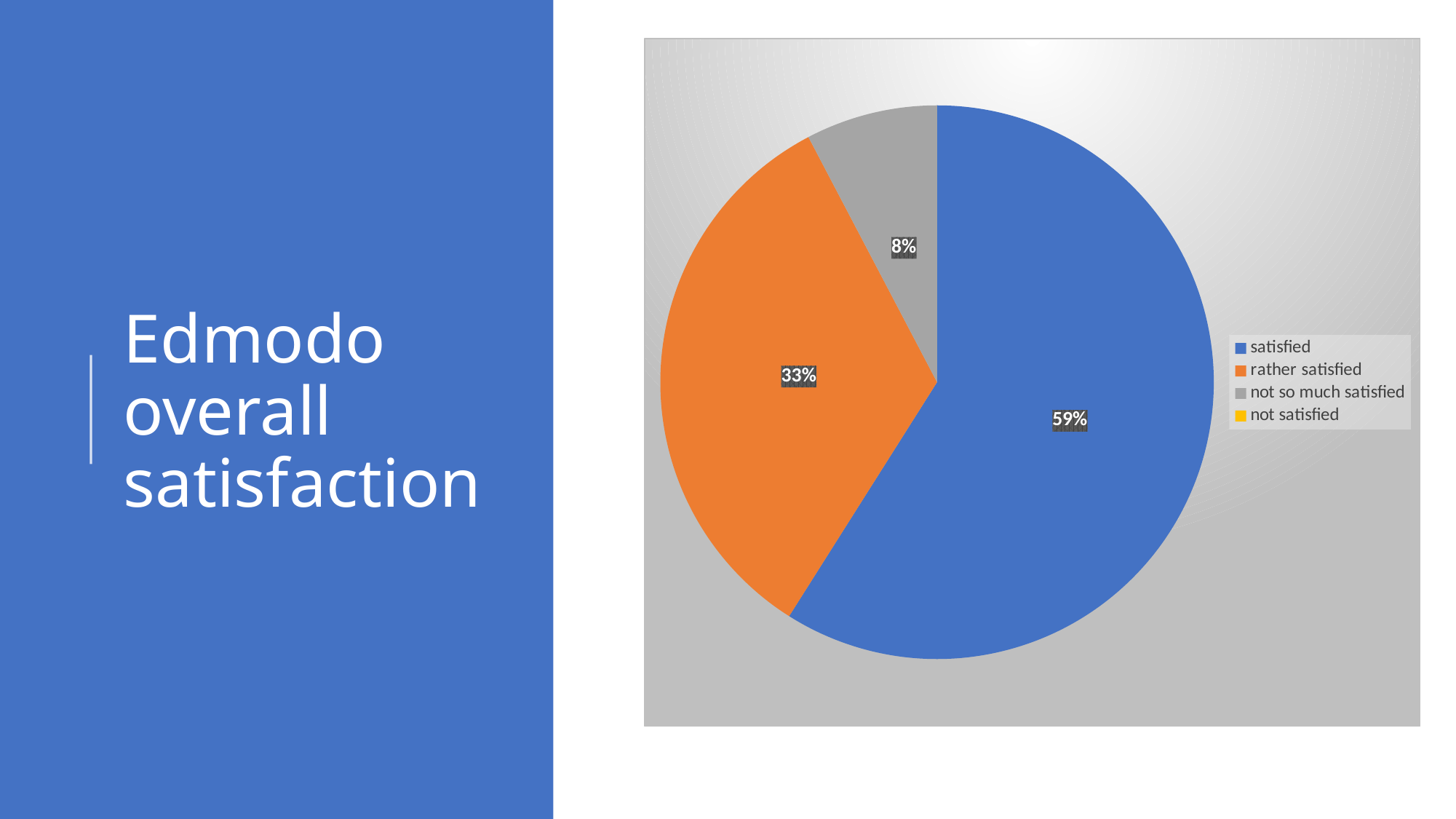
What colour is the "rather satisfied" slice? orange How many categories does the legend list? 4 Which category has the largest slice of the pie? satisfied What is the difference in percentage points between the "rather satisfied" and "not so much satisfied" slices? 25 What share of the pie is labelled "rather satisfied"? 33% Which category with a visible slice has the smallest share of the pie? not so much satisfied What share of the pie is labelled "satisfied"? 59% What kind of chart is shown on the slide? pie chart What is the difference in percentage points between the "satisfied" and "rather satisfied" slices? 26 What share of the pie is labelled "not so much satisfied"? 8% Which legend entry is shown in yellow? not satisfied Which is larger, the "rather satisfied" slice or the "not so much satisfied" slice? rather satisfied